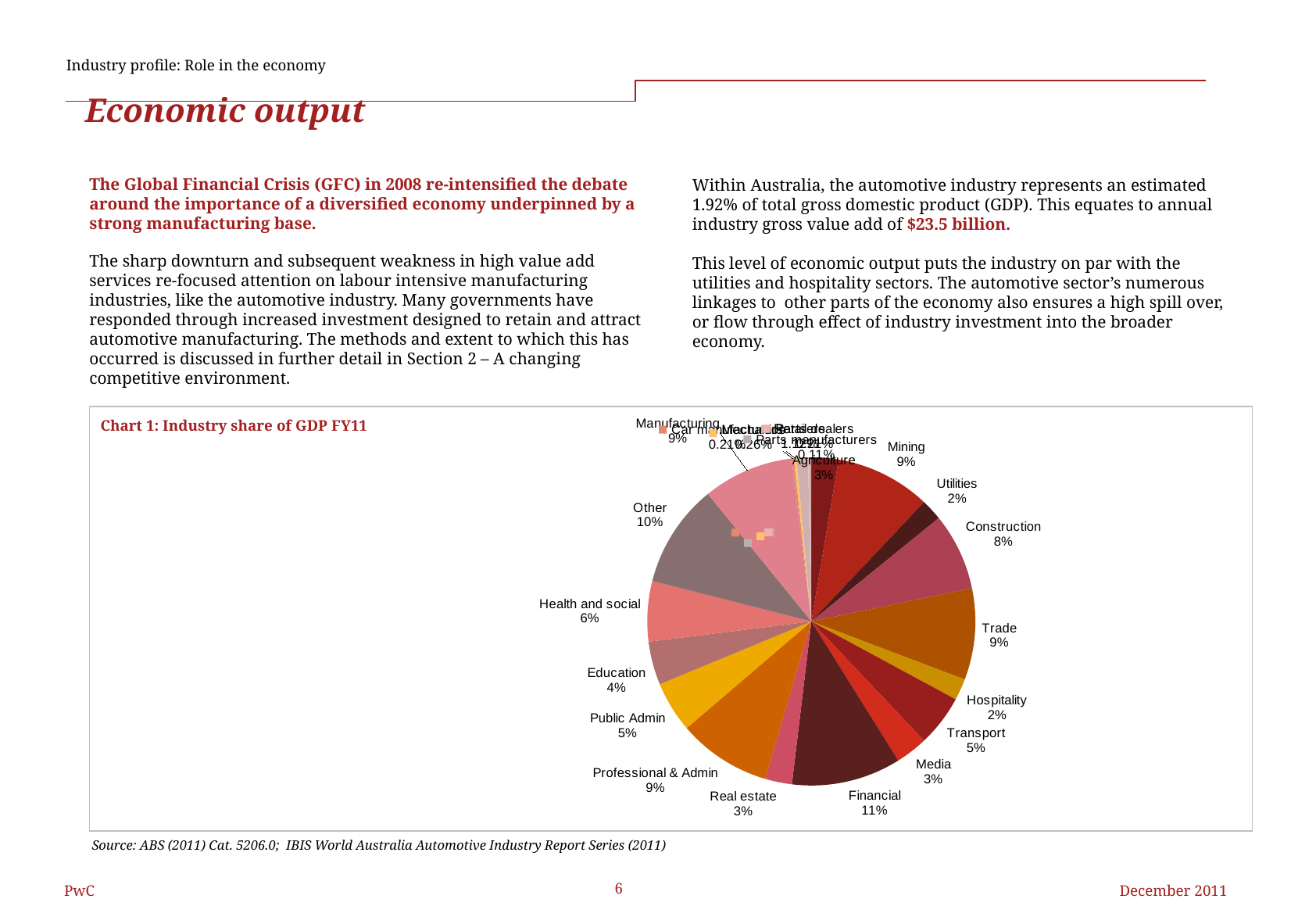
What share of GDP does Health and social hold in Chart 1? 6% In Chart 1, what is the difference in GDP share between Other and Health and social? 4% What share of GDP does Utilities hold in Chart 1? 2% What share of GDP does Construction hold in Chart 1? 8% What share of GDP does the Financial sector hold in Chart 1? 11% What is the title of the chart on the slide? Chart 1: Industry share of GDP FY11 What type of chart is Chart 1: Industry share of GDP FY11? pie chart Which labelled sector has the largest share of GDP in Chart 1? Financial In Chart 1, which has a larger share of GDP: Education or Public Admin? Public Admin What share of GDP does the Other category hold in Chart 1? 10% In Chart 1, which has a larger share of GDP: Transport or Media? Transport In Chart 1, what is the difference in GDP share between Financial and Construction? 3%